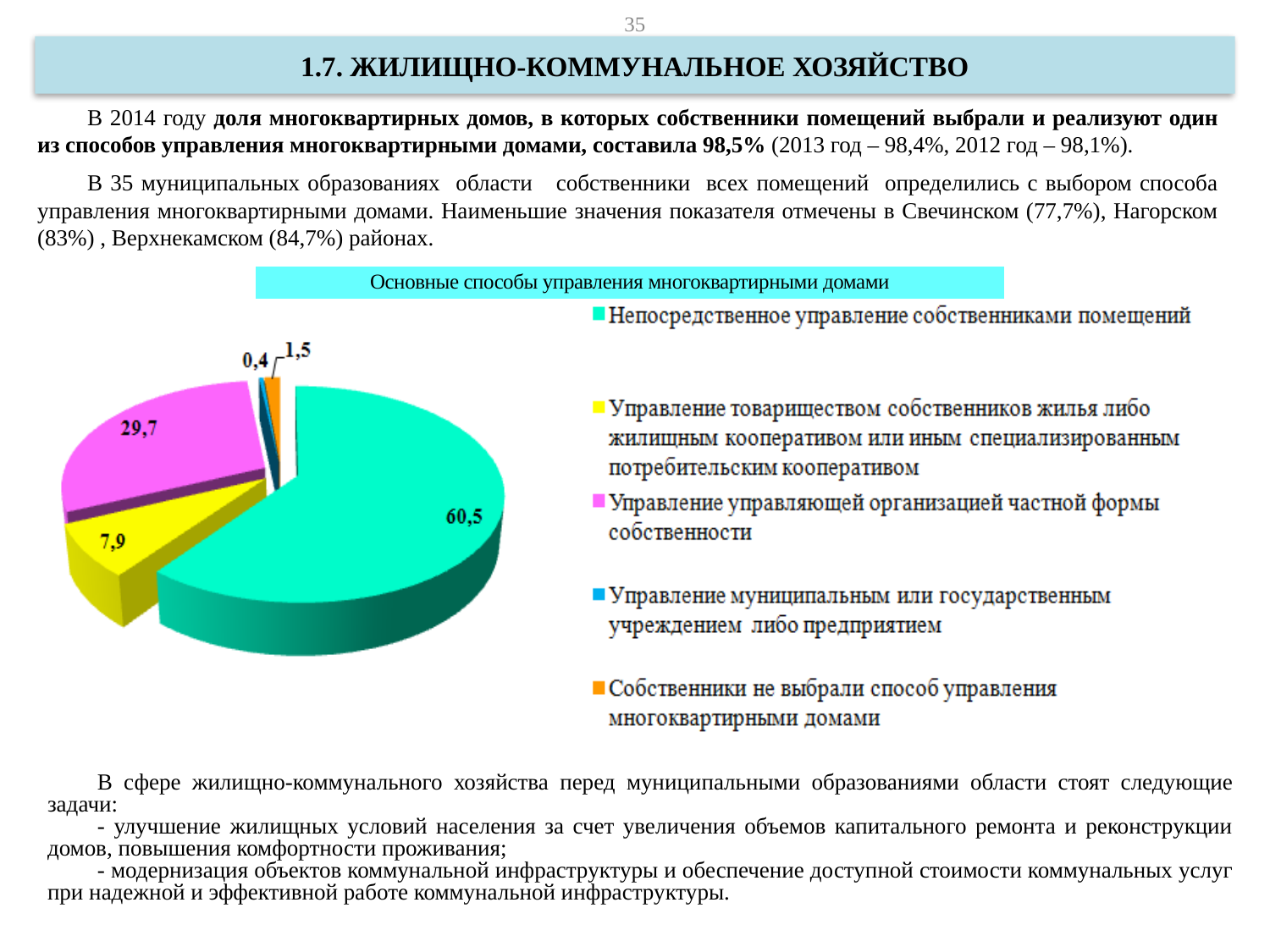
What is the value for 'Собственники не выбрали способ управления многоквартирными домами'? 1,5 What is the difference between the values for 'Непосредственное управление собственниками помещений' and 'Управление управляющей организацией частной формы собственности'? 30,8 What is the value for 'Непосредственное управление собственниками помещений'? 60,5 What is the value for 'Управление товариществом собственников жилья либо жилищным кооперативом или иным специализированным потребительским кооперативом'? 7,9 Which is larger: the value for 'Управление товариществом собственников жилья...' or the value for 'Собственники не выбрали способ управления многоквартирными домами'? Управление товариществом собственников жилья... How many entries does the legend list? 5 Which category has the smallest slice of the pie? Управление муниципальным или государственным учреждением либо предприятием What is the value for 'Управление управляющей организацией частной формы собственности'? 29,7 What kind of chart is shown on the slide? pie chart How many slices does the pie chart have? 5 What is the title of the chart? Основные способы управления многоквартирными домами Which category has the largest slice of the pie? Непосредственное управление собственниками помещений